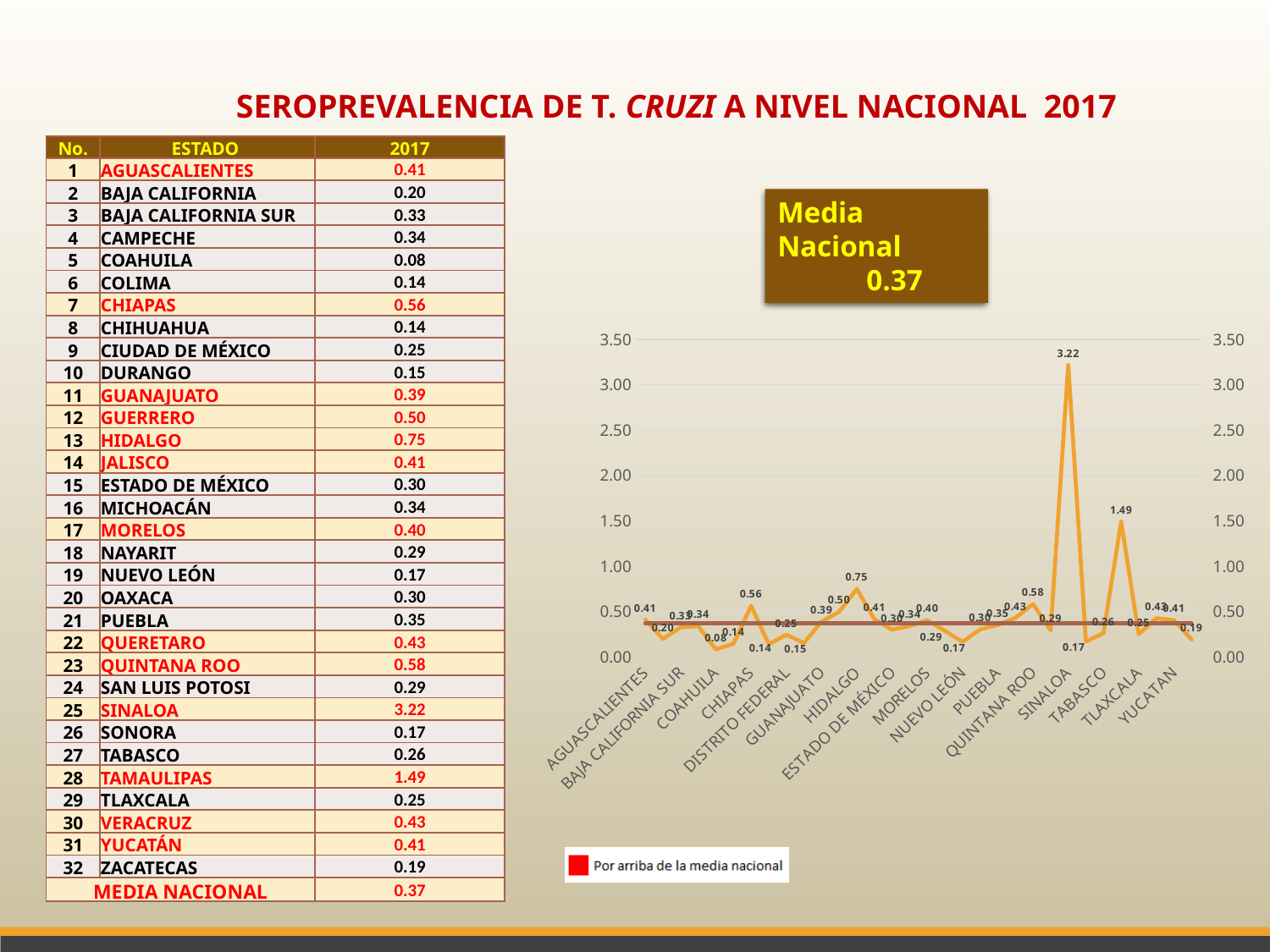
What is the value of the Media Nacional shown in the box above the chart? 0.37 What is the value plotted for Hidalgo? 0.75 What is the difference between the values for Sinaloa (3.22) and Tamaulipas (1.49)? 1.73 Which state has the highest seroprevalence value in the chart? Sinaloa How many states are plotted along the x axis of the chart? 32 Is the value for Sinaloa greater or less than 3.00? greater What is the value plotted for Chiapas? 0.56 What is the value plotted for Quintana Roo? 0.58 Which is larger, the value for Hidalgo or the value for Chiapas? Hidalgo What kind of chart is shown on the slide? line chart What is the seroprevalence value plotted for Sinaloa? 3.22 Which state has the lowest value in the chart? Coahuila